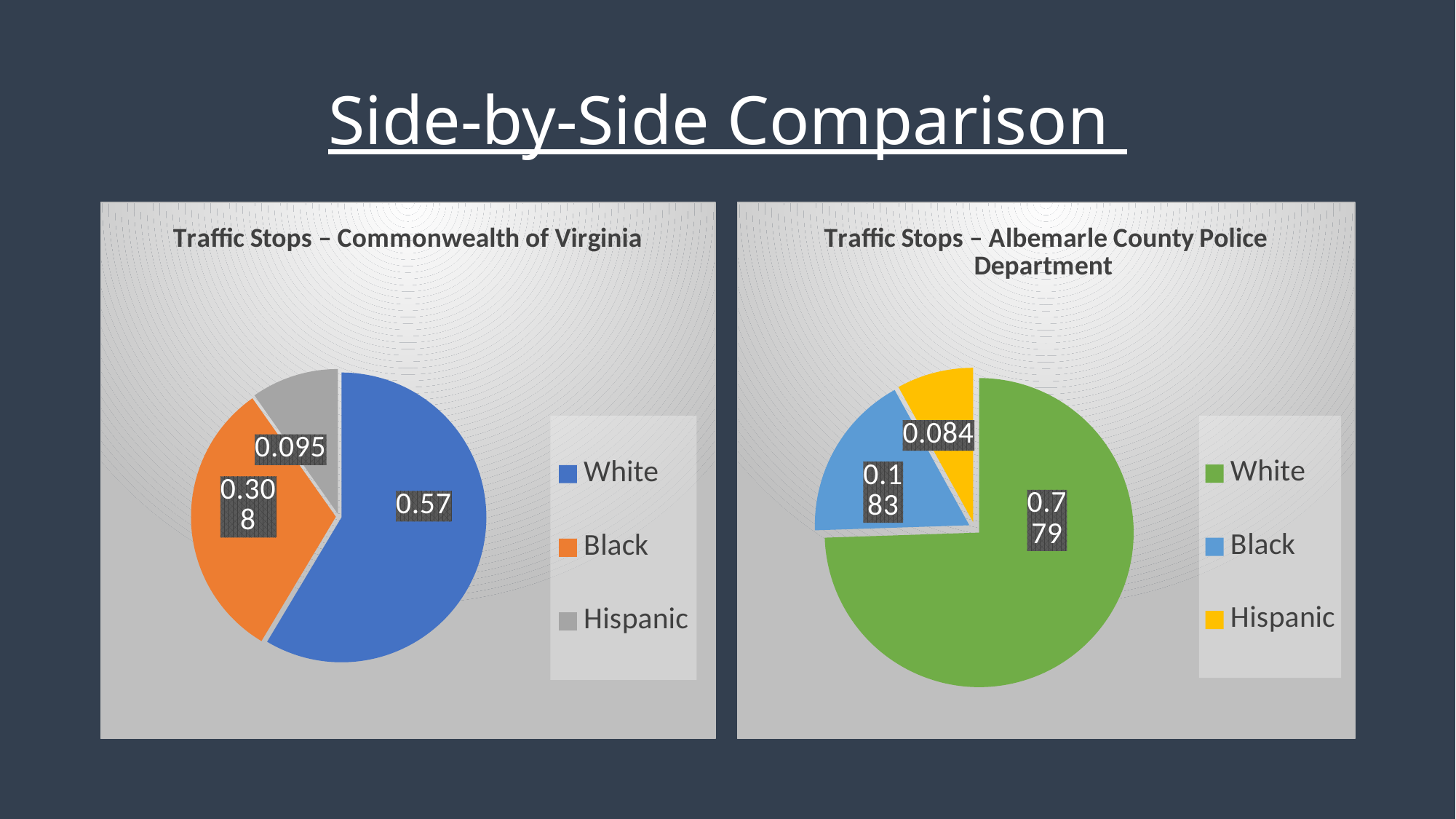
Which is larger: the Black value in the Commonwealth of Virginia chart or the Black value in the Albemarle County Police Department chart? Commonwealth of Virginia In the Traffic Stops – Albemarle County Police Department chart, what is the value for Black? 0.183 In the Traffic Stops – Albemarle County Police Department chart, which category has the largest slice? White In the Traffic Stops – Commonwealth of Virginia chart, which category has the smallest slice? Hispanic How many categories does the legend of the Traffic Stops – Commonwealth of Virginia chart list? 3 In the Traffic Stops – Commonwealth of Virginia chart, what is the value for Black? 0.308 In the Traffic Stops – Albemarle County Police Department chart, what is the value for Hispanic? 0.084 What type of chart is the Traffic Stops – Albemarle County Police Department chart? Pie chart What is the difference between the White values in the Albemarle County Police Department chart and the Commonwealth of Virginia chart? 0.209 In the Traffic Stops – Albemarle County Police Department chart, what is the value for White? 0.779 In the Traffic Stops – Commonwealth of Virginia chart, what is the value for White? 0.57 In the Traffic Stops – Commonwealth of Virginia chart, what is the value for Hispanic? 0.095